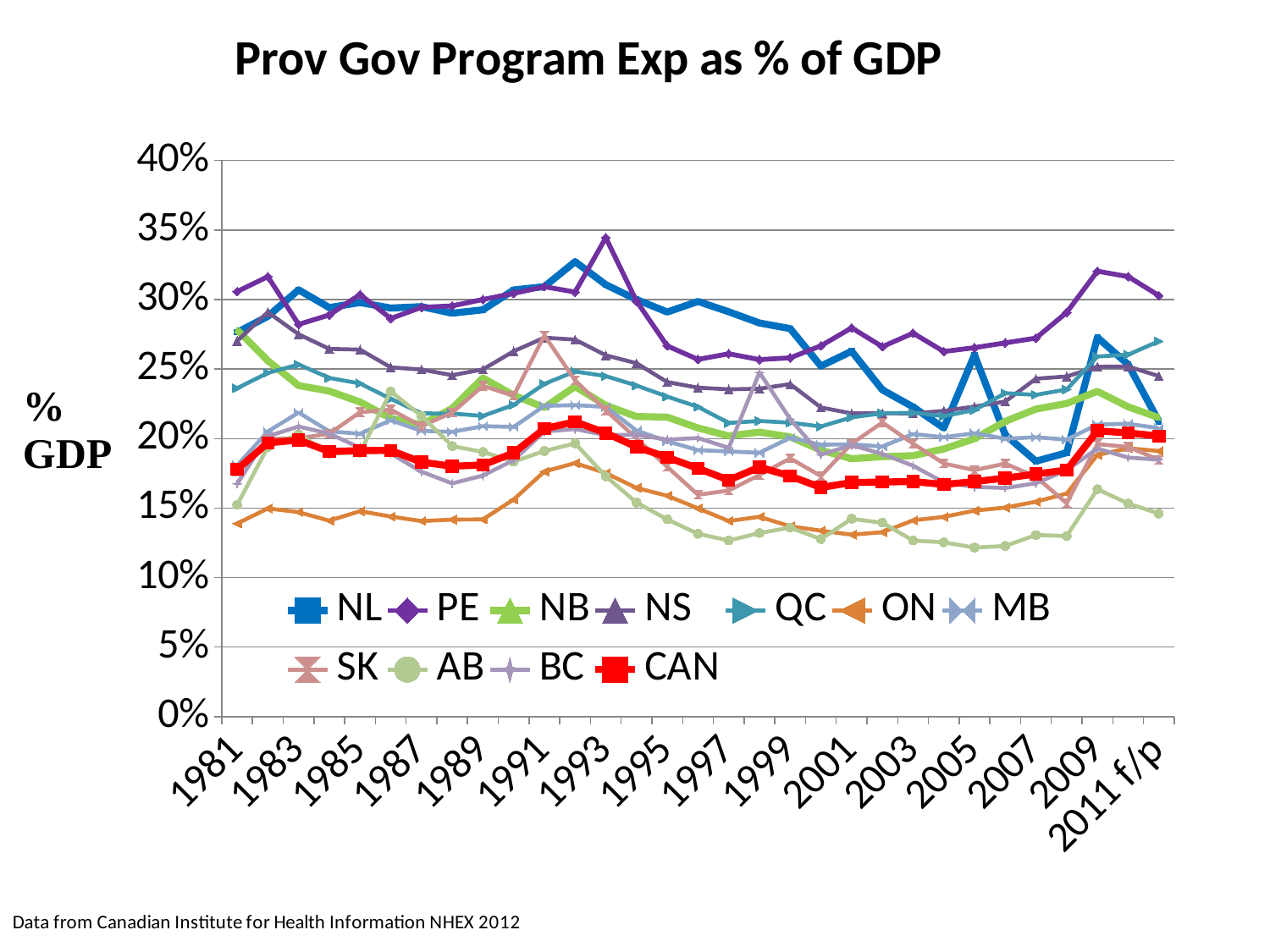
What kind of chart is shown on the slide? line chart Is the value for AB in 2005 greater or less than 15%? less Does the PE line rise or fall between 1993 and 1997? fall What is the title of the chart? Prov Gov Program Exp as % of GDP Which series has the lowest value in 2005? AB Is the value for CAN in 1981 greater or less than 20%? less Which is larger in 2005, the value for PE or the value for AB? PE How many year labels are shown on the x axis? 16 Is the value for PE in 1993 greater or less than 30%? greater What is the label on the vertical axis? % GDP Which series has the highest value in 1993? PE How many series does the legend list? 11